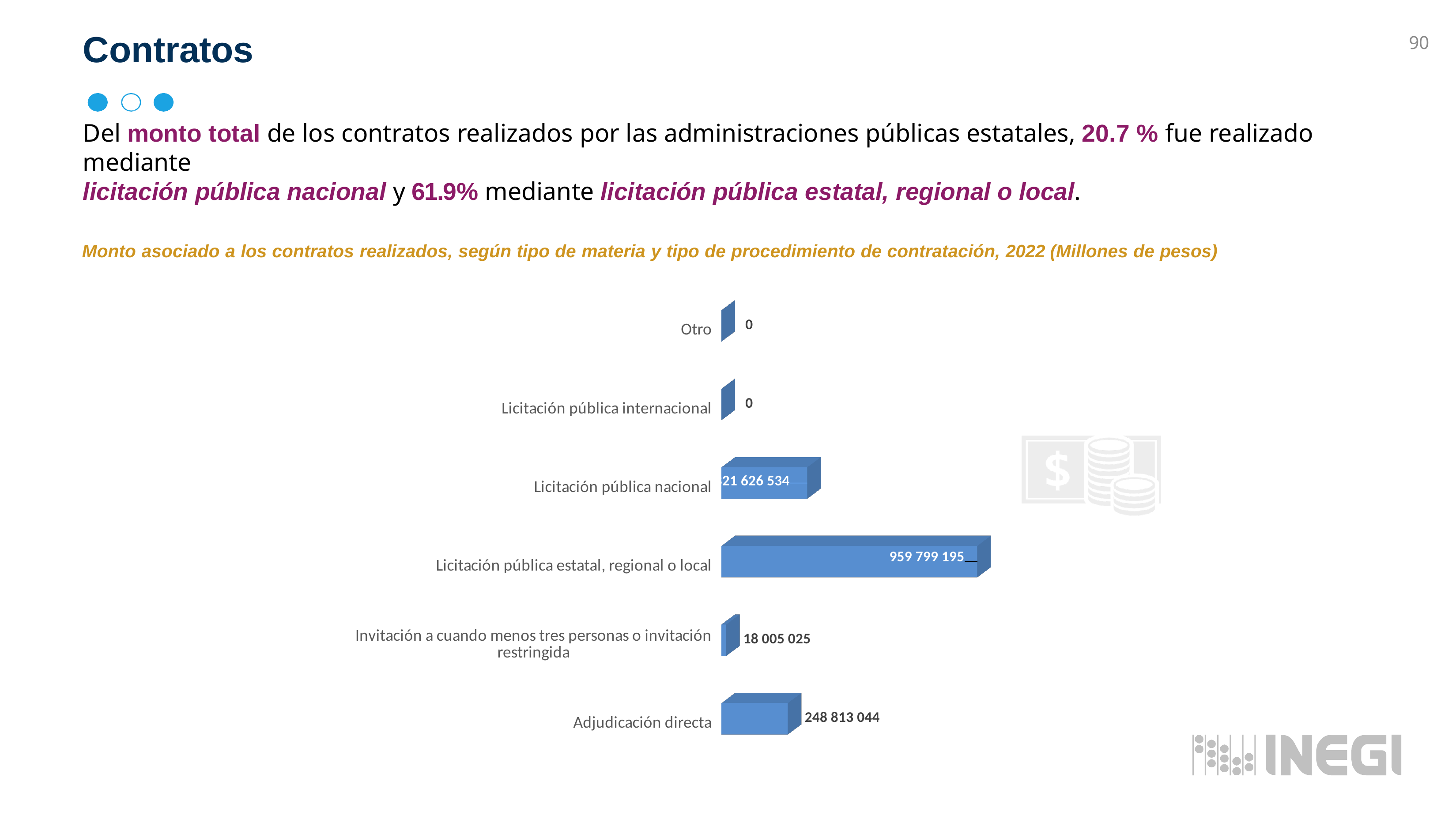
What is the value for Adjudicación directa? 248 813 044 What is the value for Invitación a cuando menos tres personas o invitación restringida? 18 005 025 What is the value for Otro? 0 What year does the chart title say the data refers to? 2022 What is the difference between the values for Adjudicación directa and Invitación a cuando menos tres personas o invitación restringida? 230 808 019 Which category has the highest value in the chart? Licitación pública estatal, regional o local What is the value for Licitación pública internacional? 0 What is the difference between the values for Licitación pública estatal, regional o local and Adjudicación directa? 710 986 151 Which is larger: the value for Adjudicación directa or the value for Invitación a cuando menos tres personas o invitación restringida? Adjudicación directa What is the value for Licitación pública estatal, regional o local? 959 799 195 How many categories (procedure types) are shown in the chart? 6 What type of chart is shown on the slide? bar chart